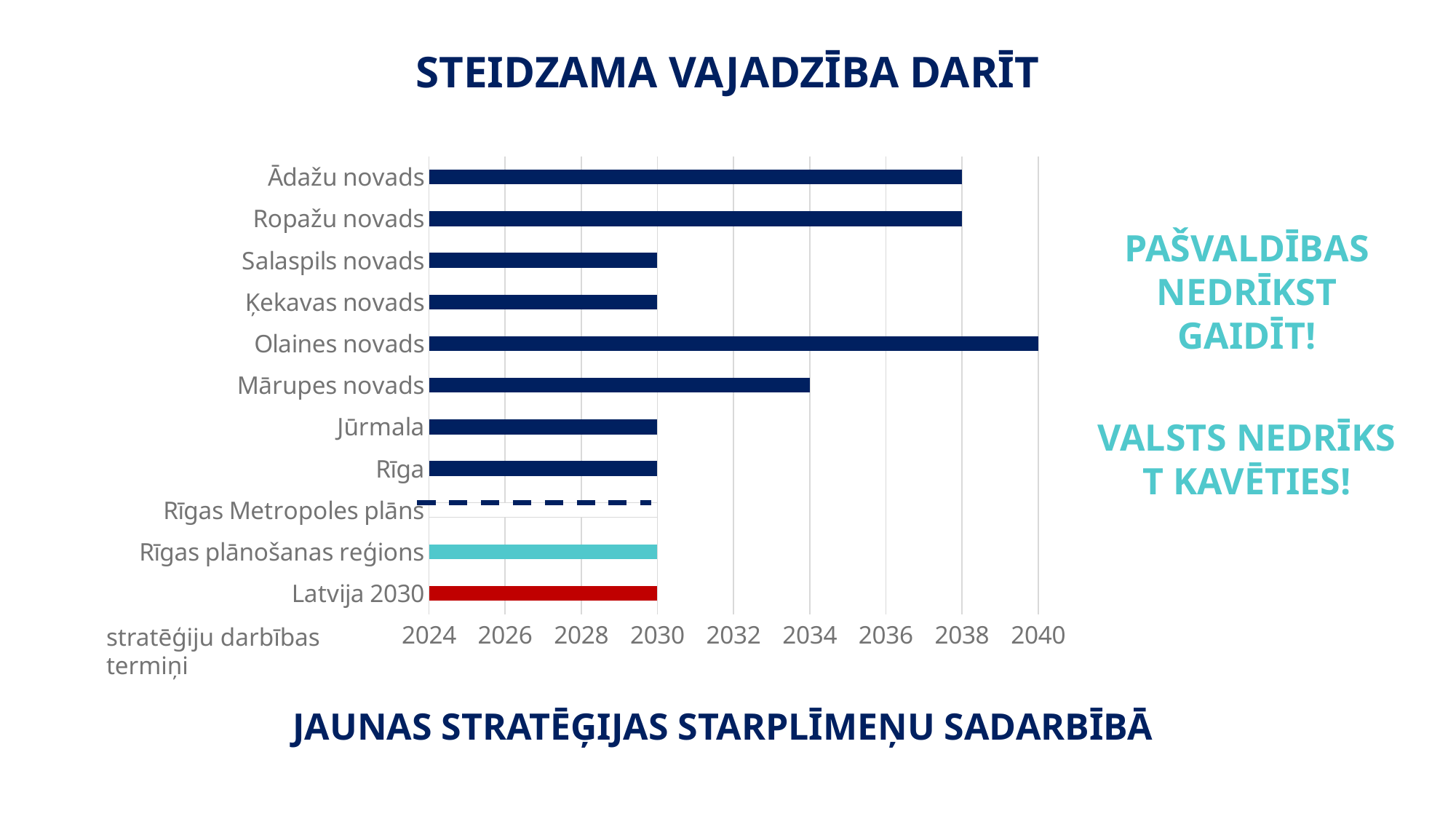
At which year does the bar for Latvija 2030 end? 2030 Which category has the bar extending furthest along the x axis? Olaines novads At which year does the bar for Ādažu novads end? 2038 How many categories are listed on the vertical axis of the chart? 11 At which year does the bar for Olaines novads end? 2040 What kind of chart is shown on the slide? Bar chart At which year does the bar for Mārupes novads end? 2034 What colour is the bar for Latvija 2030? Red Which bar extends further: Ropažu novads or Mārupes novads? Ropažu novads Is the end year of the Mārupes novads bar greater or less than 2032? greater How many years later does the Olaines novads bar end compared with the Mārupes novads bar? 6 Which category is drawn as a dashed line instead of a solid bar? Rīgas Metropoles plāns